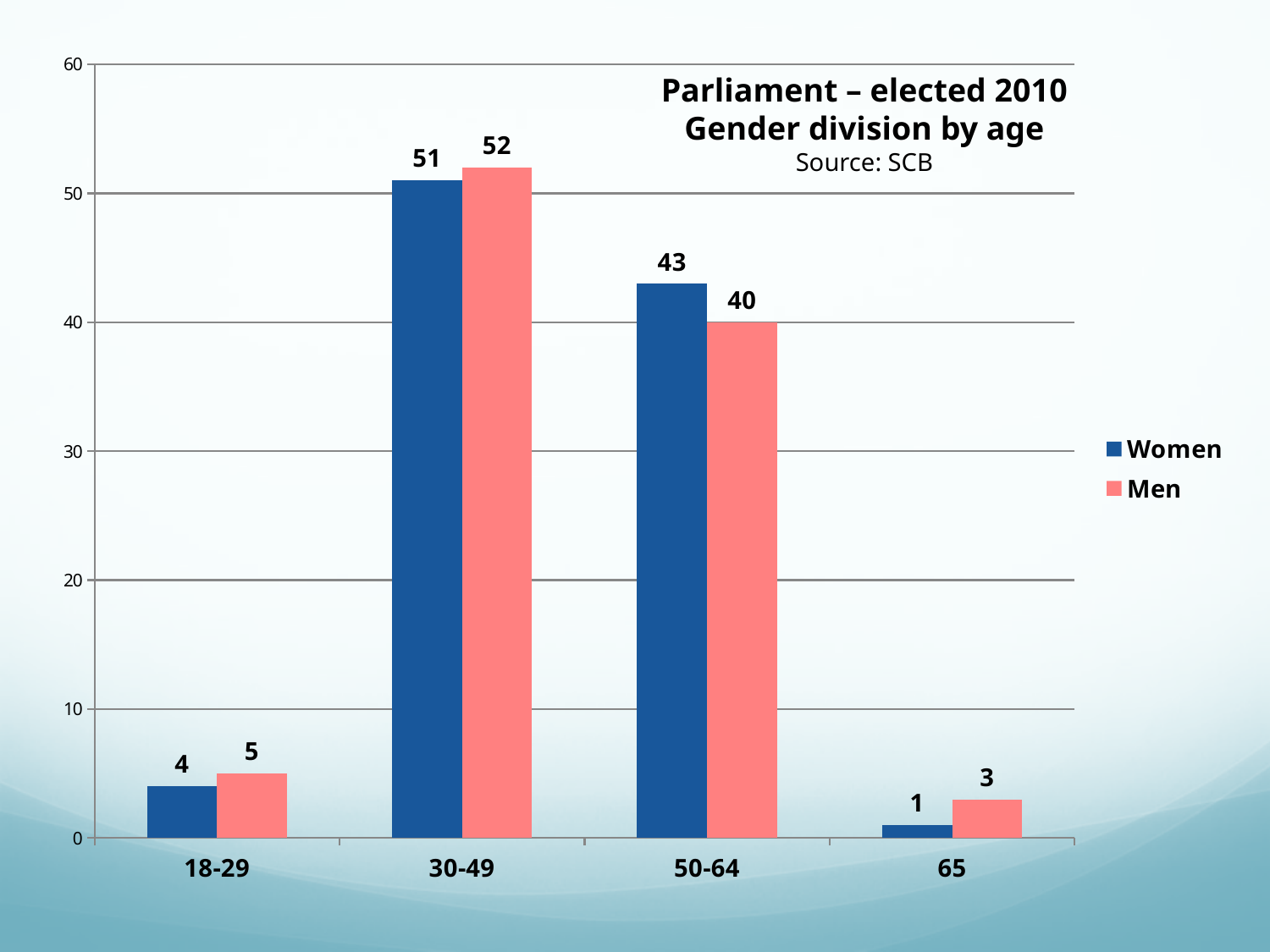
What is the value for Men in the 50-64 age group? 40 Which age group has the highest value for Men? 30-49 What is the value for Women in the 65 age group? 1 How many series does the legend list? 2 Is the value for Women in the 50-64 age group greater or less than 40? greater What source is cited for the chart? SCB What is the difference between the Women and Men values in the 50-64 age group? 3 What kind of chart is shown on the slide? Bar chart Which age group has the lowest value for Women? 65 How many age groups are shown on the x axis? 4 What is the value for Women in the 30-49 age group? 51 In the 18-29 age group, which is larger, the value for Women or for Men? Men